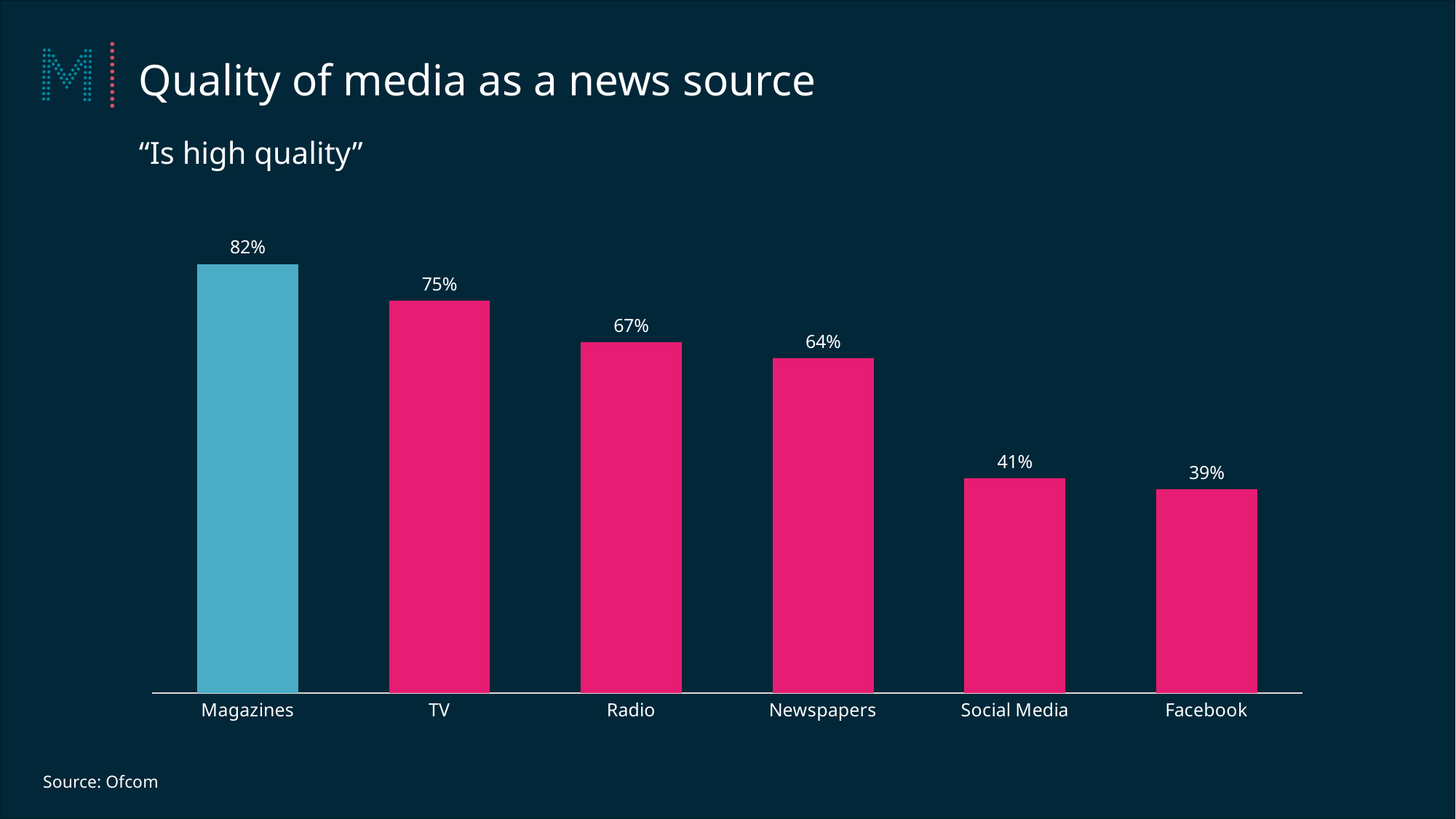
What percentage of respondents said magazines are high quality as a news source? 82% Which media source has the lowest value for "Is high quality"? Facebook What is the value shown for Social Media? 41% Which bar is coloured differently from the others? Magazines What is the difference between the values for Magazines and Facebook? 43 percentage points What is the value shown for Newspapers? 64% Which media source has the highest value for "Is high quality"? Magazines What is the difference between the values for Radio and Newspapers? 3 percentage points How many media sources are shown in the chart? 6 Which has a higher value, TV or Radio? TV What is the value shown for TV? 75% What type of chart is shown on the slide? Bar chart